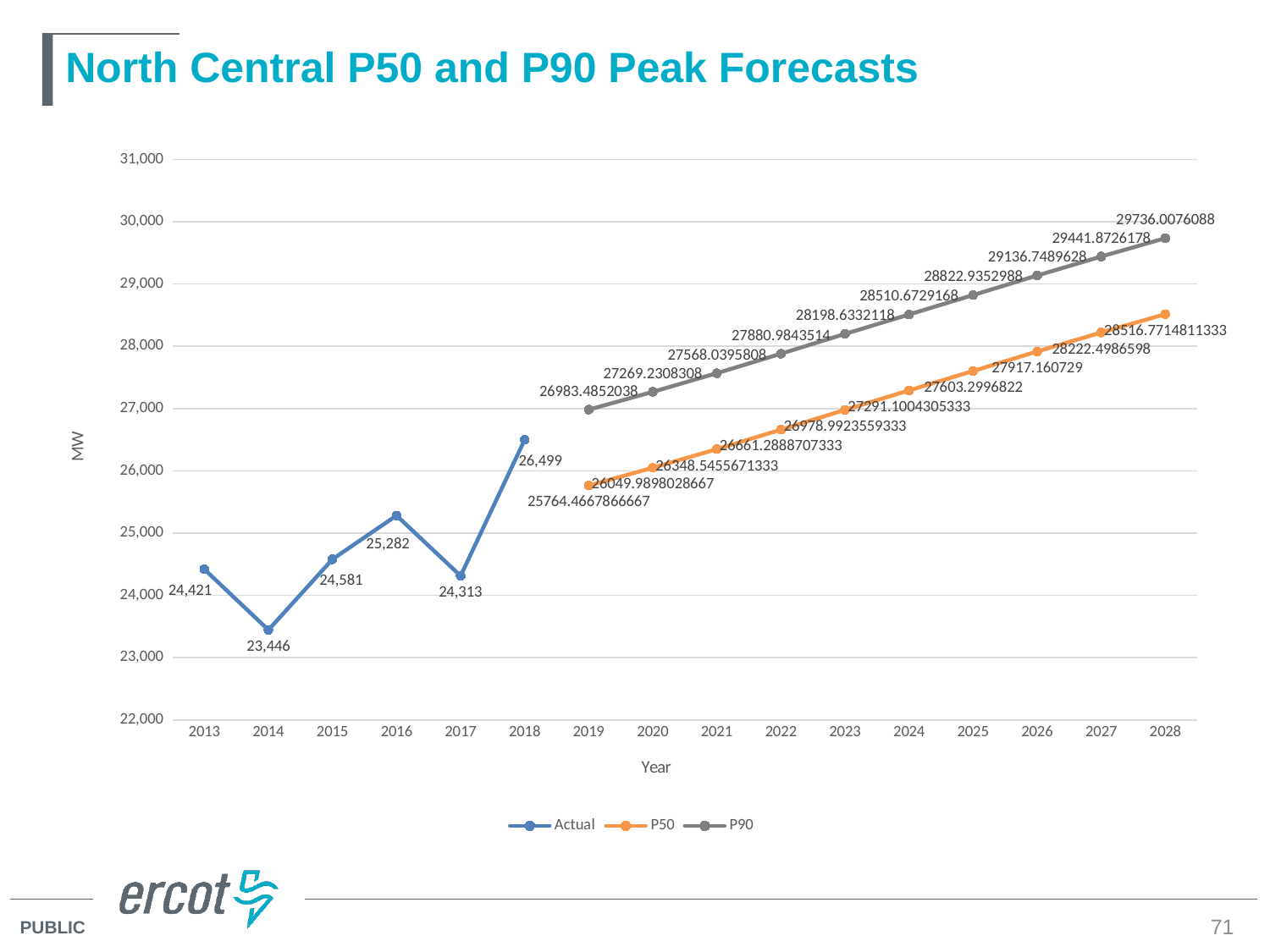
What is the Actual value for 2014? 23,446 How many series does the legend list? 3 Which year has the lowest Actual value? 2014 How many years are shown on the x axis? 16 What is the P90 value for 2028? 29736.0076088 Which is larger in 2025, the P50 value or the P90 value? P90 Which year has the highest Actual value? 2018 What is the P50 value for 2019? 25764.4667866667 What is the difference between the Actual values for 2018 and 2017? 2,186 Does the P90 series rise or fall from 2019 to 2028? Rise What type of chart is shown on the slide? Line chart What is the Actual value for 2018? 26,499